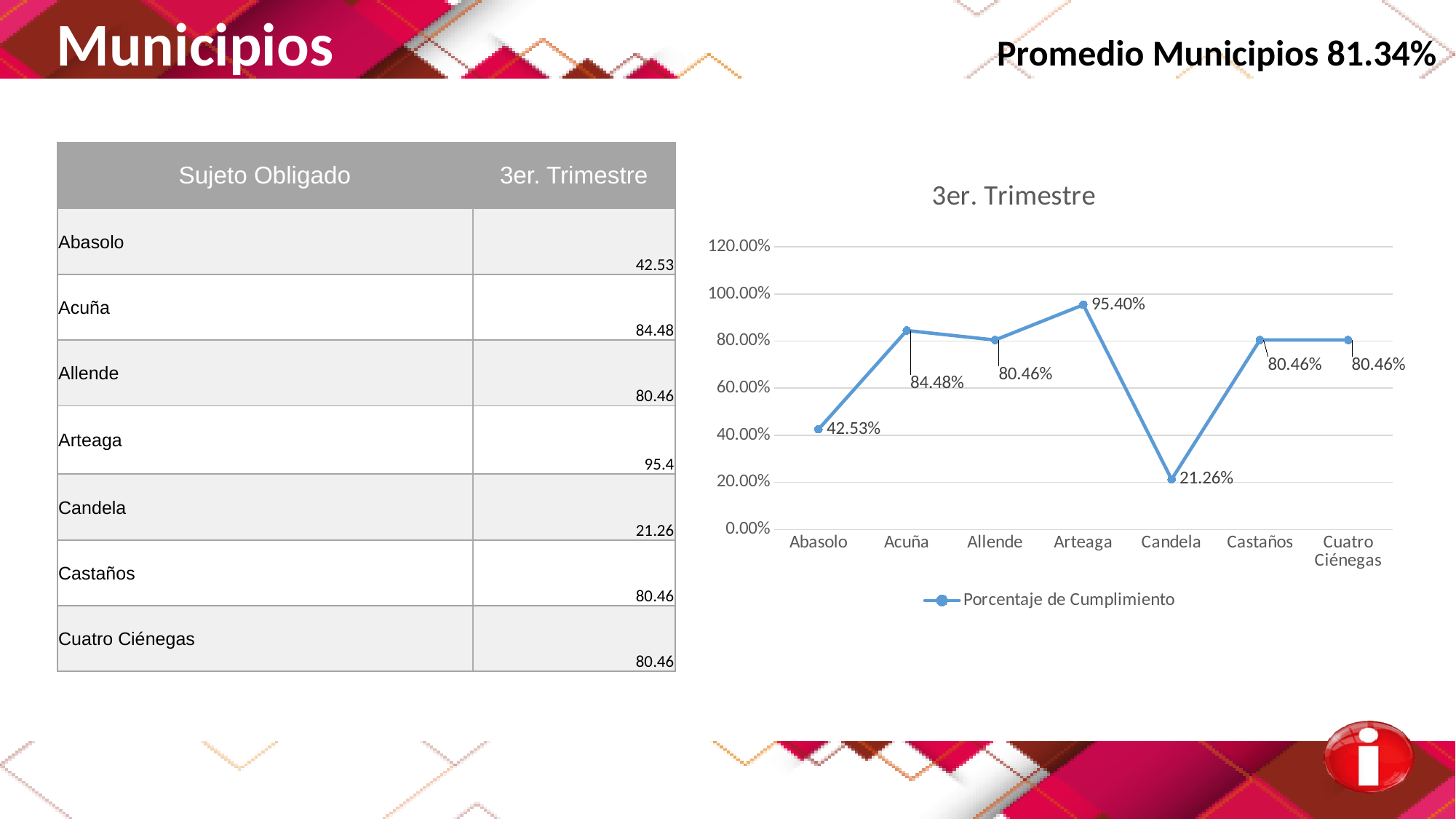
Which municipality has the lowest value in the chart? Candela What is the value for Abasolo in the chart? 42.53% What is the difference between the values for Arteaga and Candela? 74.14% Which municipality has the highest value in the chart? Arteaga What is the value for Arteaga in the chart? 95.40% Is the value for Abasolo greater or less than 60.00%? less What kind of chart is shown on the slide? line chart Which has a larger value, Acuña or Allende? Acuña How many municipalities are plotted on the x axis of the chart? 7 What is the title of the chart? 3er. Trimestre What is the value for Candela in the chart? 21.26% How many series does the chart legend list? 1